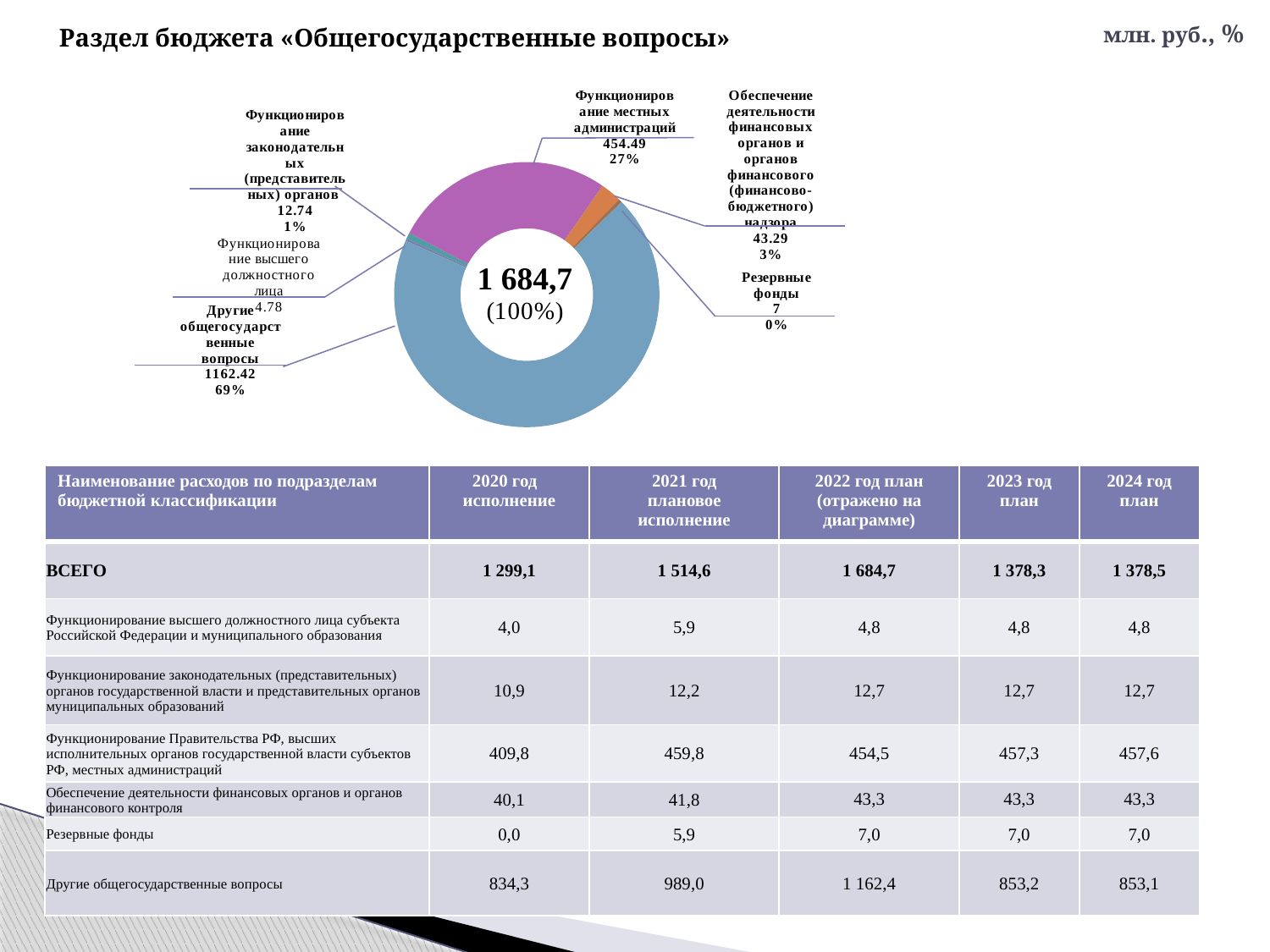
What share of the donut chart does «Другие общегосударственные вопросы» take? 69% What value is shown for «Функционирование местных администраций» on the donut chart? 454.49 What value is shown for «Резервные фонды» on the donut chart? 7 What value is shown for «Функционирование законодательных (представительных) органов» on the donut chart? 12.74 What value is shown for «Обеспечение деятельности финансовых органов и органов финансового (финансово-бюджетного) надзора» on the donut chart? 43.29 What kind of chart is shown on the slide? Donut (pie) chart Which category has the smallest slice of the donut chart? Функционирование высшего должностного лица What total value is shown in the centre of the donut chart? 1 684,7 (100%) What value is shown for «Другие общегосударственные вопросы» on the donut chart? 1162.42 What percentage is shown for «Функционирование местных администраций» on the donut chart? 27% How many slices does the donut chart have? 6 Which category has the largest slice of the donut chart? Другие общегосударственные вопросы